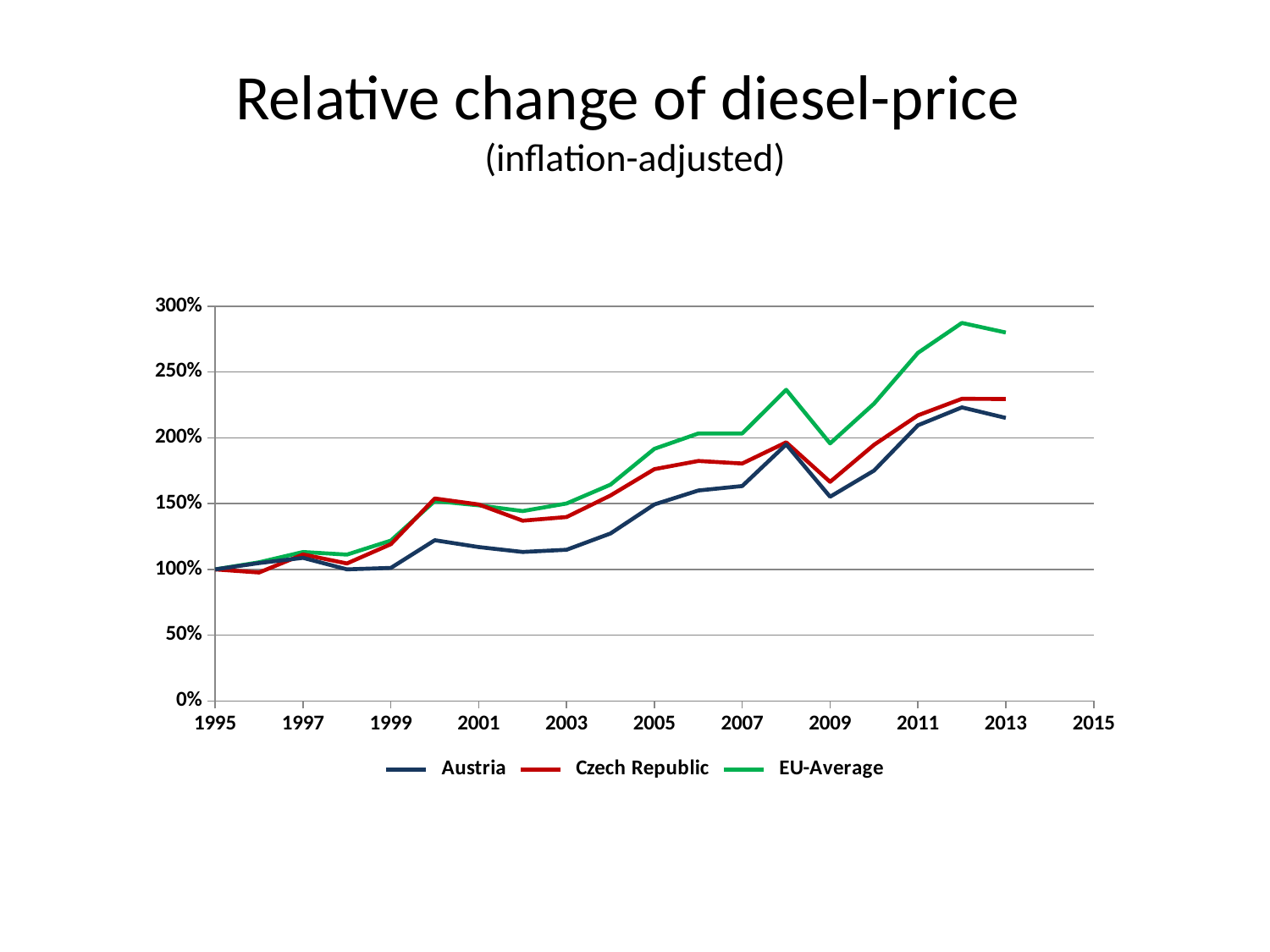
Which series has the highest value in 2013? EU-Average Do the values for EU-Average generally rise or fall from 1995 to 2013? rise Is the value for Czech Republic in 2013 greater or less than 200%? greater What is the title of the chart? Relative change of diesel-price (inflation-adjusted) What is the value for Austria in 1995? 100% Which series has the lowest value in 2013? Austria Which is larger in 2013, the value for Czech Republic or the value for Austria? Czech Republic How many series does the legend list? 3 What kind of chart is shown on the slide? line chart Is the value for Austria in 2009 greater or less than 200%? less Is the value for EU-Average in 2012 greater or less than 250%? greater Which series are listed in the legend? Austria, Czech Republic, EU-Average